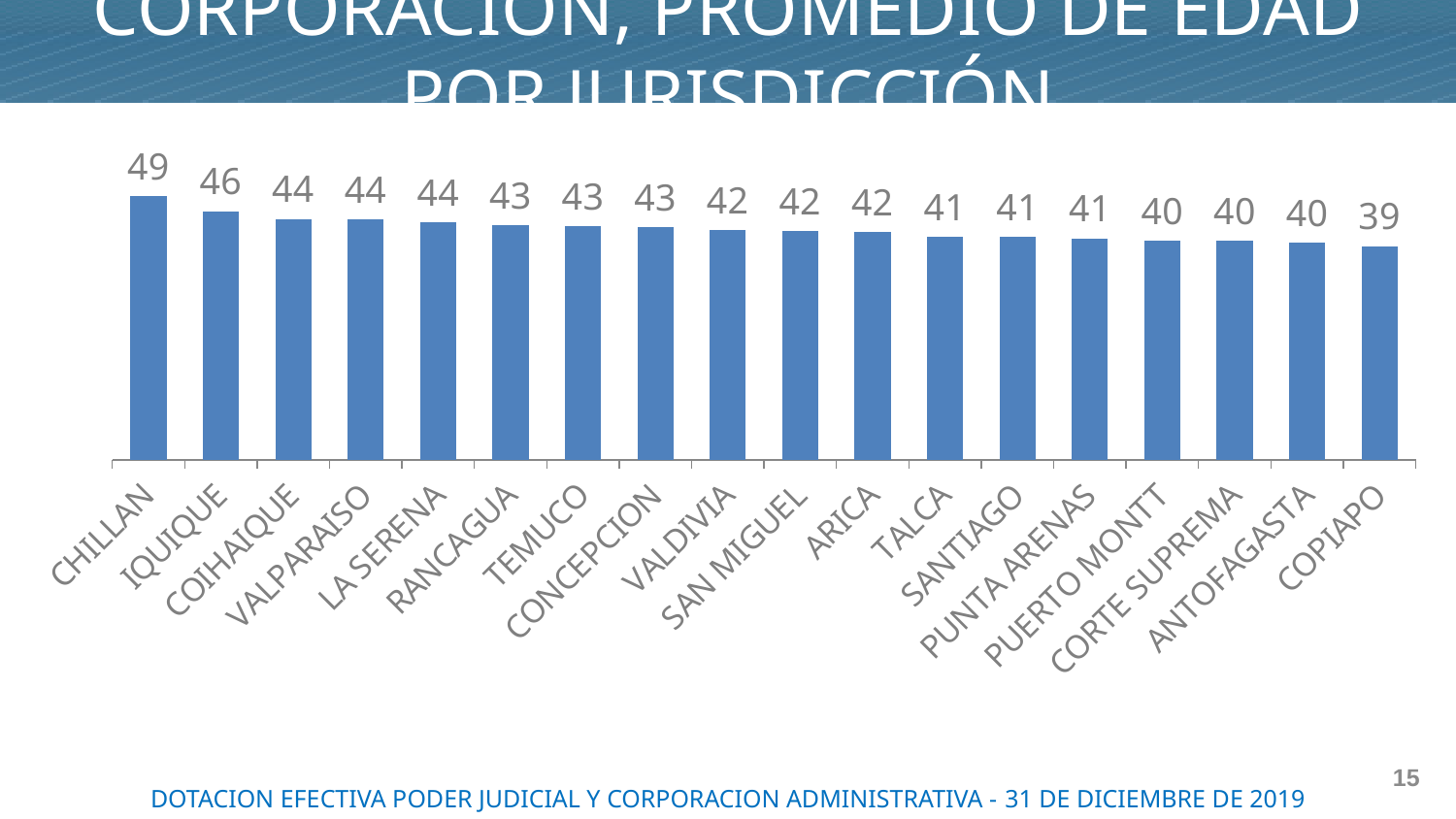
Which jurisdiction has the highest value? CHILLAN How many jurisdictions are shown in the chart? 18 What kind of chart is shown on the slide? Bar chart Which is larger, the value for IQUIQUE or the value for ARICA? IQUIQUE What is the value for IQUIQUE? 46 Do the values rise or fall from left to right along the x axis? Fall What is the value for CORTE SUPREMA? 40 What is the difference between the values for CHILLAN and COPIAPO? 10 What is the difference between the values for IQUIQUE and TALCA? 5 Which jurisdiction has the lowest value? COPIAPO What is the value for CHILLAN? 49 What is the value for SANTIAGO? 41